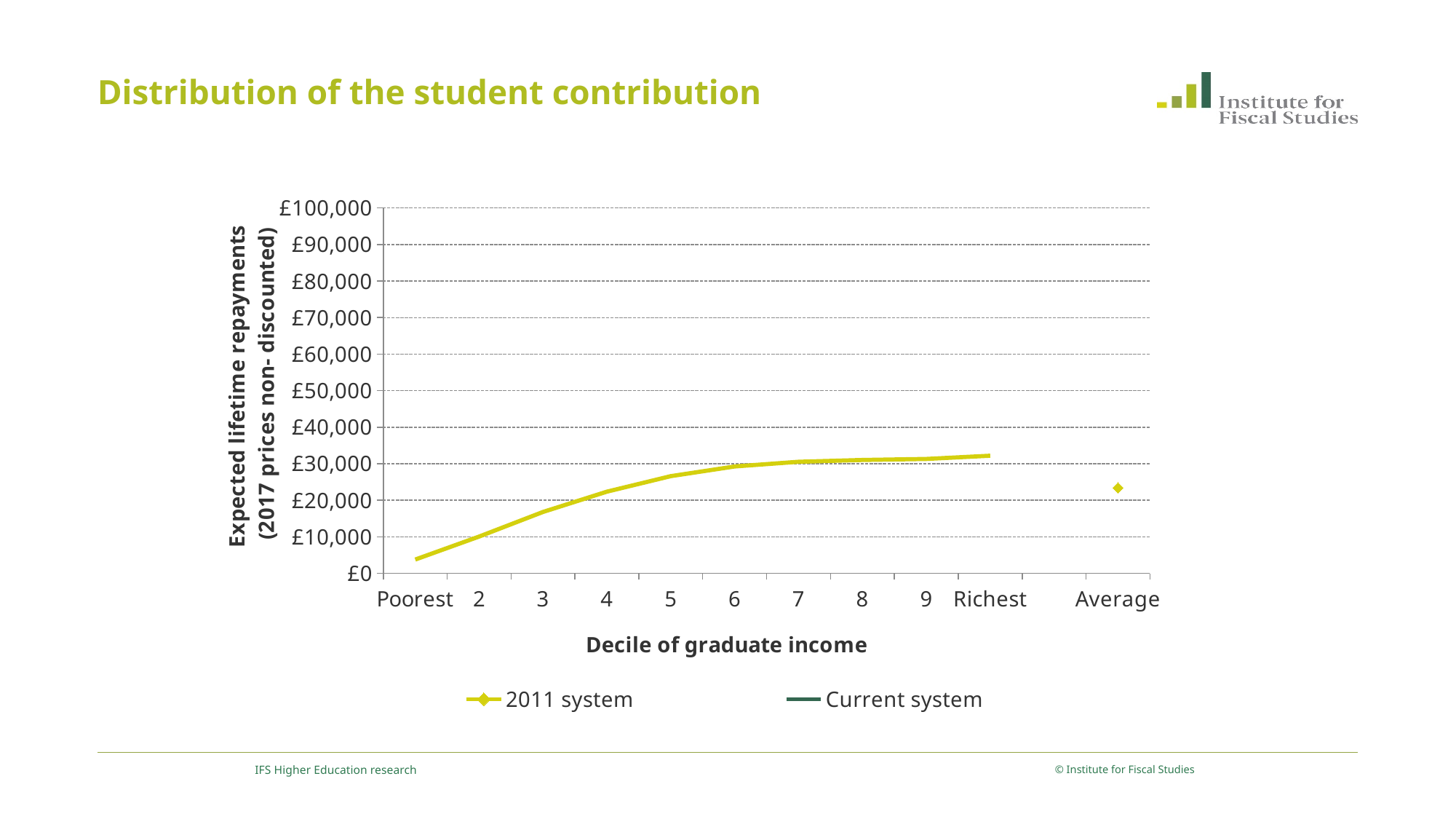
Do the 2011 system values rise or fall from the Poorest decile to the Richest decile? rise Is the 2011 system value for the Poorest decile greater or less than £10,000? less Is the 2011 system value for decile 3 greater or less than £20,000? less Which decile has the lowest expected lifetime repayments for the 2011 system? Poorest Is the 2011 system value for decile 5 greater or less than £20,000? greater How many series does the legend list? 2 Which is larger for the 2011 system: the value for the Richest decile or the Average value? Richest What kind of chart is shown on the slide? line chart How many categories are shown on the x axis? 11 Which decile has the highest expected lifetime repayments for the 2011 system? Richest